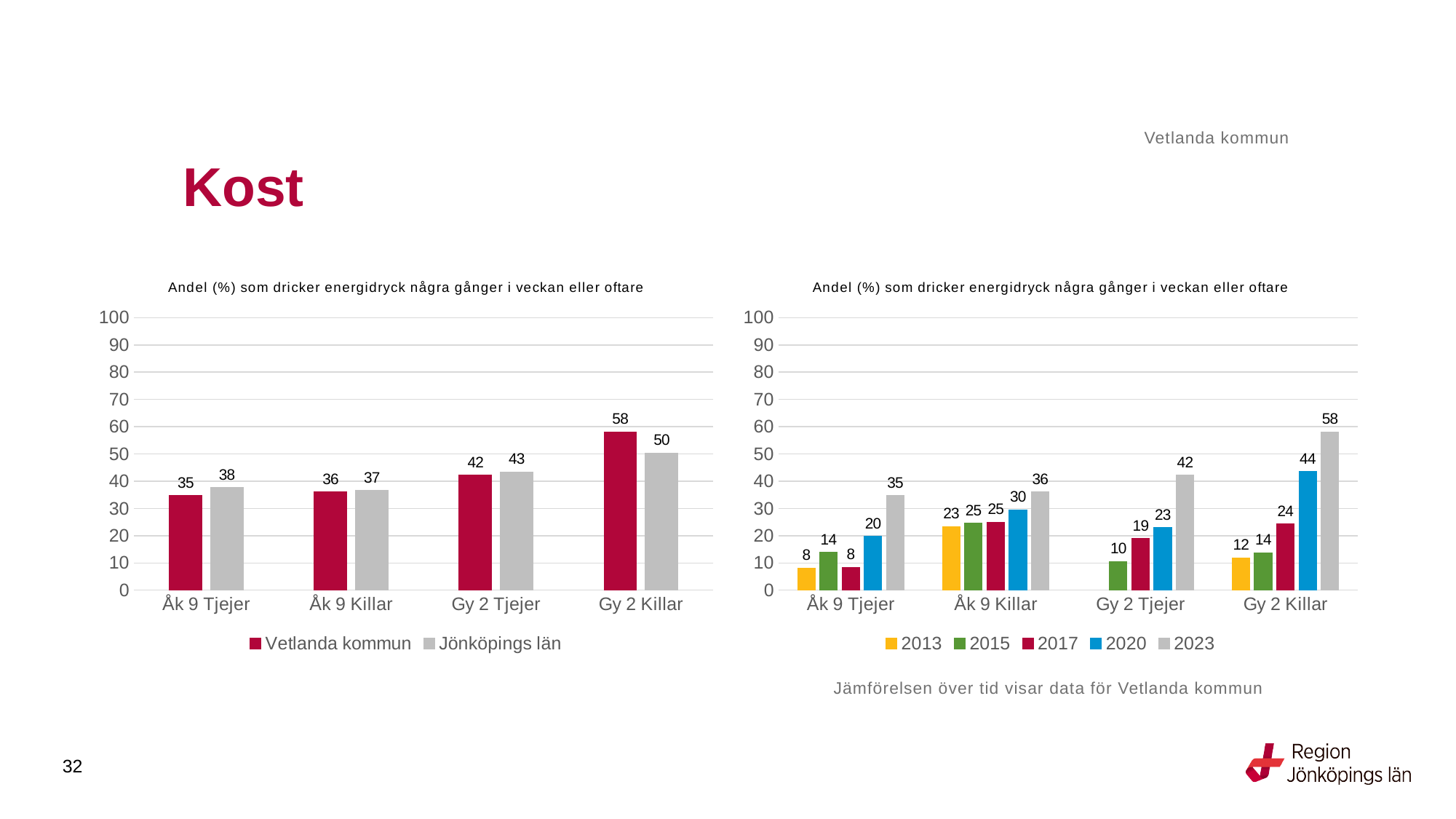
In the left chart, which is larger for Gy 2 Tjejer: Vetlanda kommun or Jönköpings län? Jönköpings län In the left chart, which category has the highest value for Vetlanda kommun? Gy 2 Killar In the left chart, what is the difference between Vetlanda kommun and Jönköpings län for Gy 2 Killar? 8 In the right chart, what is the difference between the 2023 and 2020 values for Åk 9 Tjejer? 15 In the right chart, what is the value for 2020 for Gy 2 Killar? 44 In the left chart, what is the value for Vetlanda kommun for Gy 2 Killar? 58 In the right chart, what is the value for 2013 for Åk 9 Killar? 23 How many series does the legend of the right chart list? 5 In the left chart, what is the value for Jönköpings län for Åk 9 Tjejer? 38 In the right chart, which year has the lowest value for Gy 2 Tjejer? 2015 In the right chart, do the values for Gy 2 Killar rise or fall from 2013 to 2023? rise What kind of chart is the left chart? bar chart